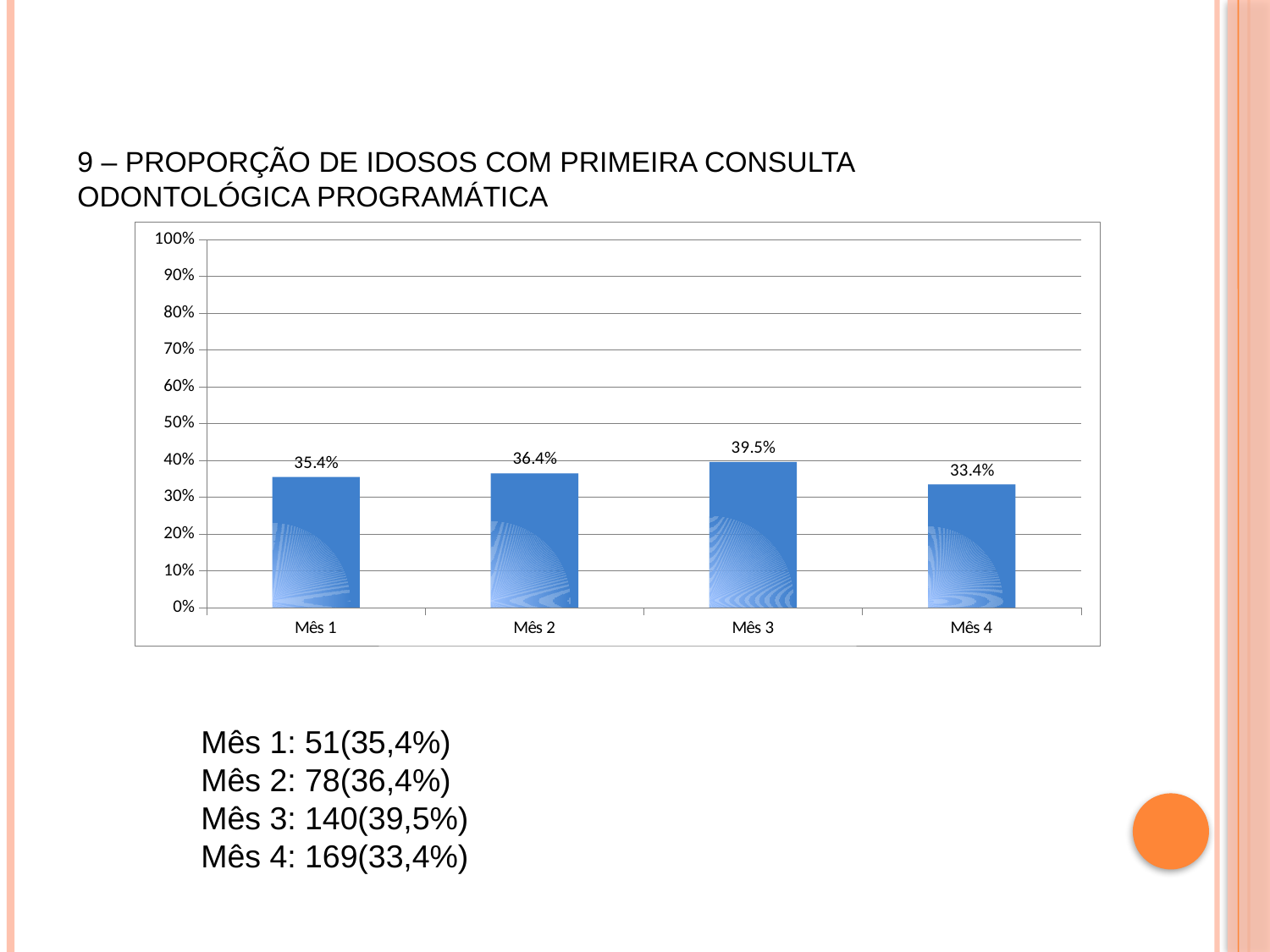
What kind of chart is shown on the slide? bar chart What is the highest value shown on the y axis? 100% Which month has the lowest value? Mês 4 Is the value for Mês 3 greater or less than 50%? less What is the value for Mês 4? 33.4% What is the value for Mês 3? 39.5% Which is larger, the value for Mês 2 or the value for Mês 4? Mês 2 What is the difference between the values for Mês 3 and Mês 4? 6.1% What is the difference between the values for Mês 2 and Mês 1? 1.0% Which month has the highest value? Mês 3 What is the value for Mês 1? 35.4% How many months are shown on the x axis? 4